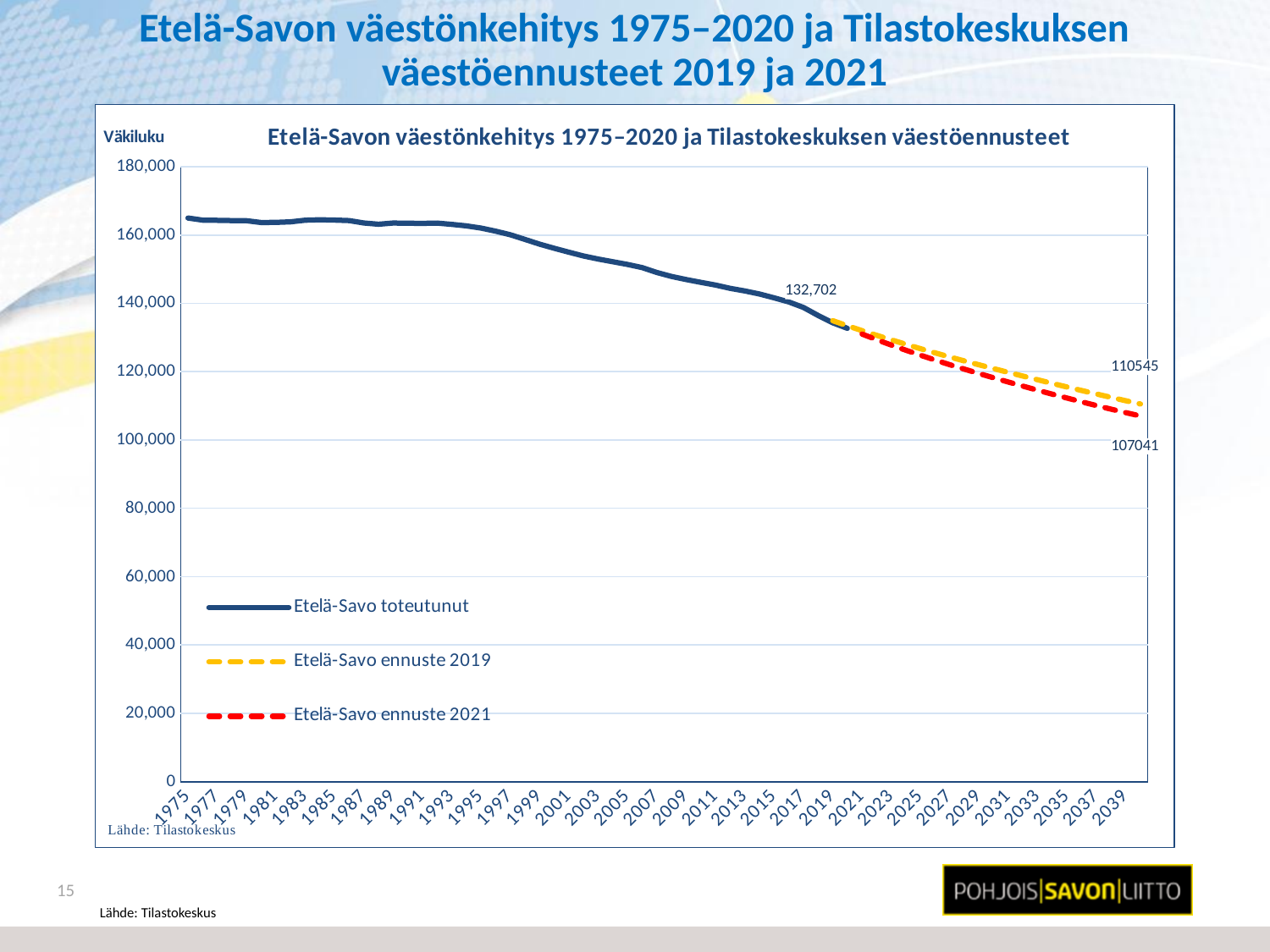
What is the labelled end value of the Etelä-Savo ennuste 2019 series? 110545 Is the value of the Etelä-Savo toteutunut series in 2009 greater or less than 140,000? greater What is the difference between the end values of the Etelä-Savo ennuste 2019 and Etelä-Savo ennuste 2021 series? 3504 What is the labelled value at the end of the Etelä-Savo toteutunut series? 132,702 Does the Etelä-Savo toteutunut series rise or fall from 1975 to 2020? fall How many series does the chart legend list? 3 Is the value of the Etelä-Savo toteutunut series in 1975 greater or less than 160,000? greater What label is shown on the vertical axis of the chart? Väkiluku Is the value of the Etelä-Savo toteutunut series in 2001 greater or less than 160,000? less What is the labelled end value of the Etelä-Savo ennuste 2021 series? 107041 Which forecast series ends at a higher value, Etelä-Savo ennuste 2019 or Etelä-Savo ennuste 2021? Etelä-Savo ennuste 2019 What type of chart is shown on the slide? line chart